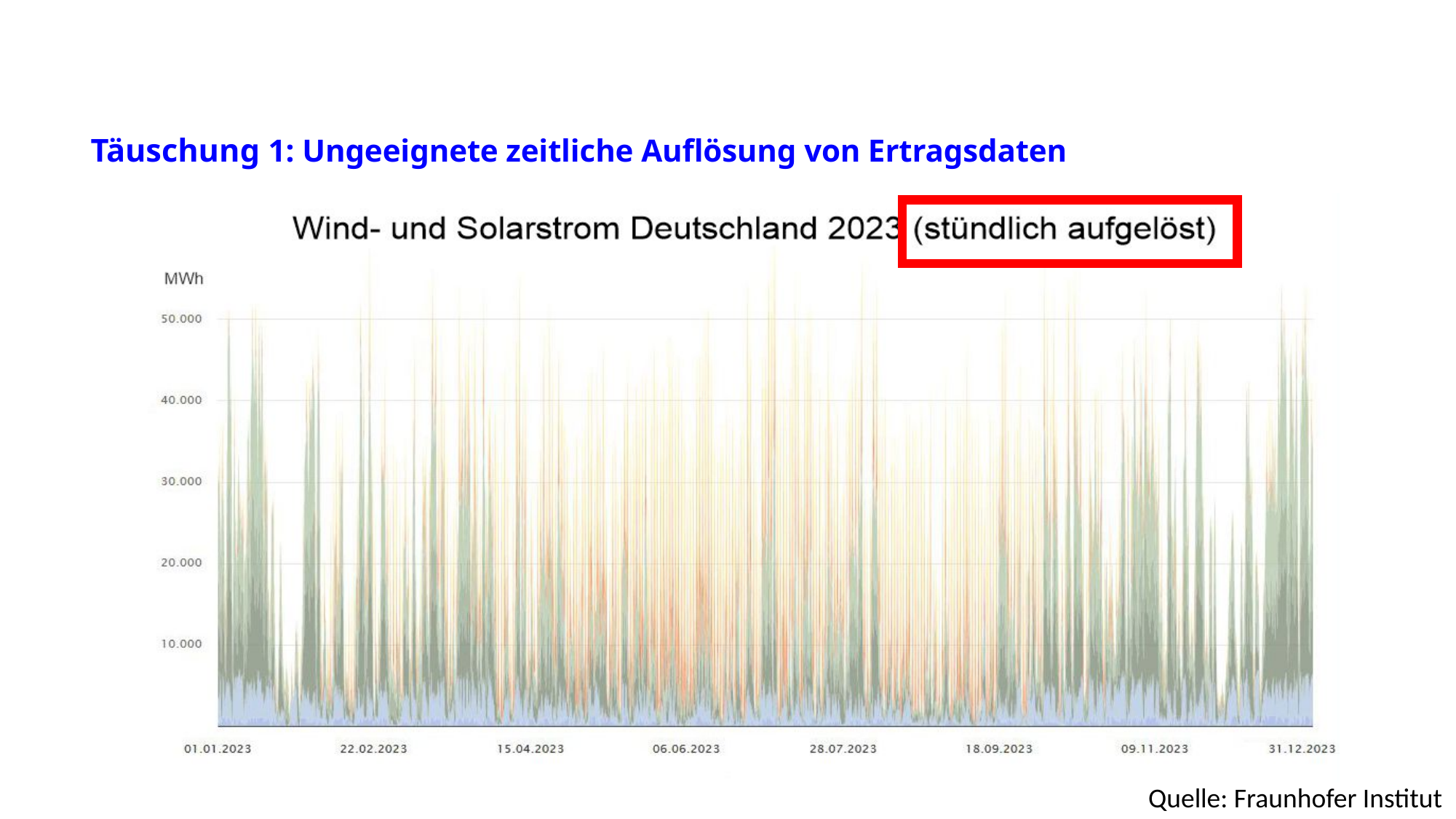
What is the highest value labelled on the y axis of the chart? 50.000 What is the first date label on the x axis of the chart? 01.01.2023 What kind of chart is shown on the slide? area chart How many date labels are shown along the x axis of the chart? 8 What unit is shown on the y axis of the chart? MWh What is the last date label on the x axis of the chart? 31.12.2023 What is the title of the chart? Wind- und Solarstrom Deutschland 2023 (stündlich aufgelöst) Do the highest peaks in the chart reach greater or less than 50.000 MWh? greater